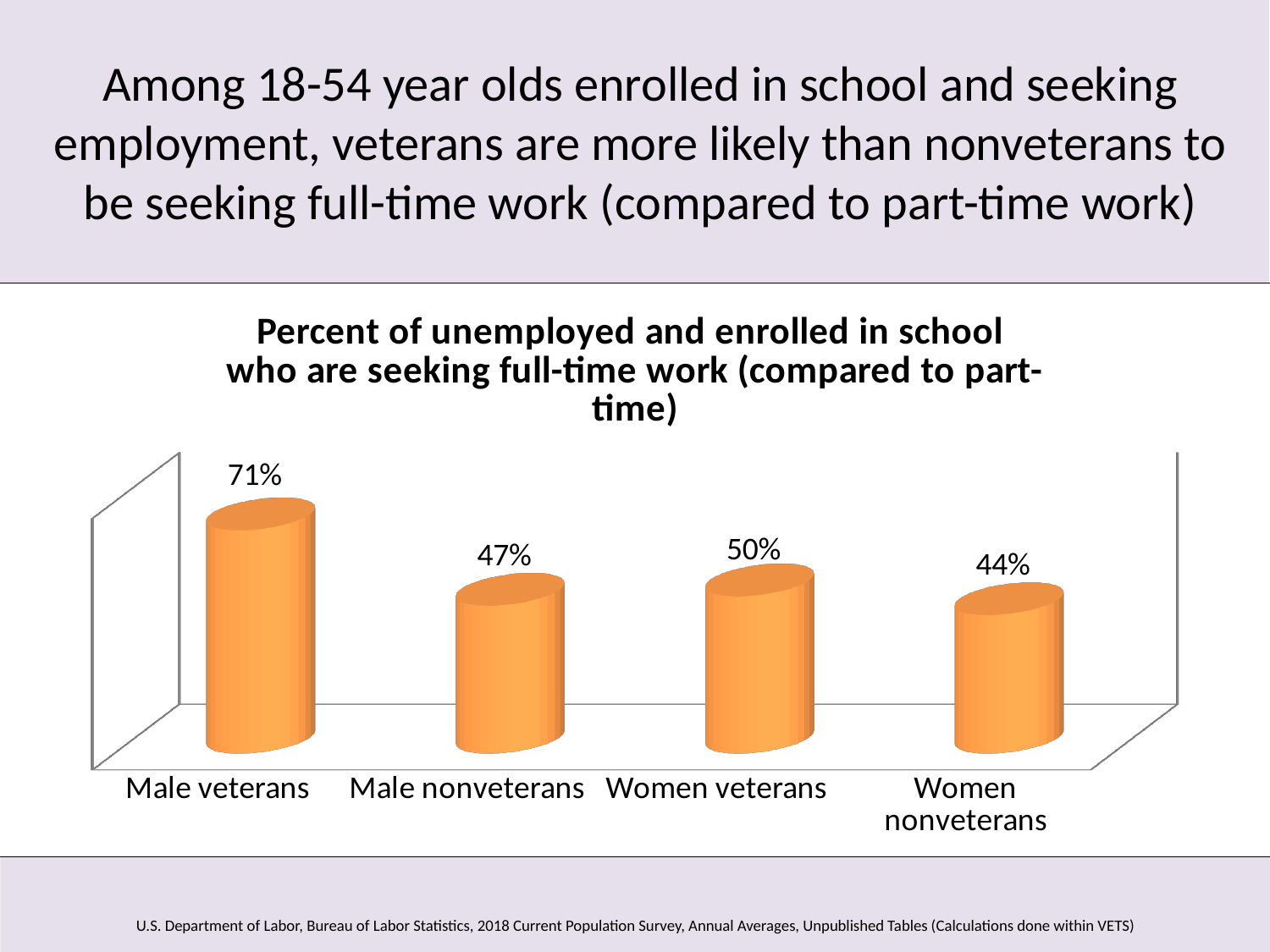
Which is larger, the value for Male nonveterans or the value for Women veterans? Women veterans What is the value for Male nonveterans? 47% What is the difference between the values for Male veterans and Male nonveterans? 24% Which category has the highest value? Male veterans What is the value for Women veterans? 50% What is the difference between the values for Women veterans and Women nonveterans? 6% How many categories are shown in the chart? 4 What is the title of the chart? Percent of unemployed and enrolled in school who are seeking full-time work (compared to part-time) What is the value for Women nonveterans? 44% What kind of chart is shown on the slide? Bar chart What is the value for Male veterans? 71% Which category has the lowest value? Women nonveterans